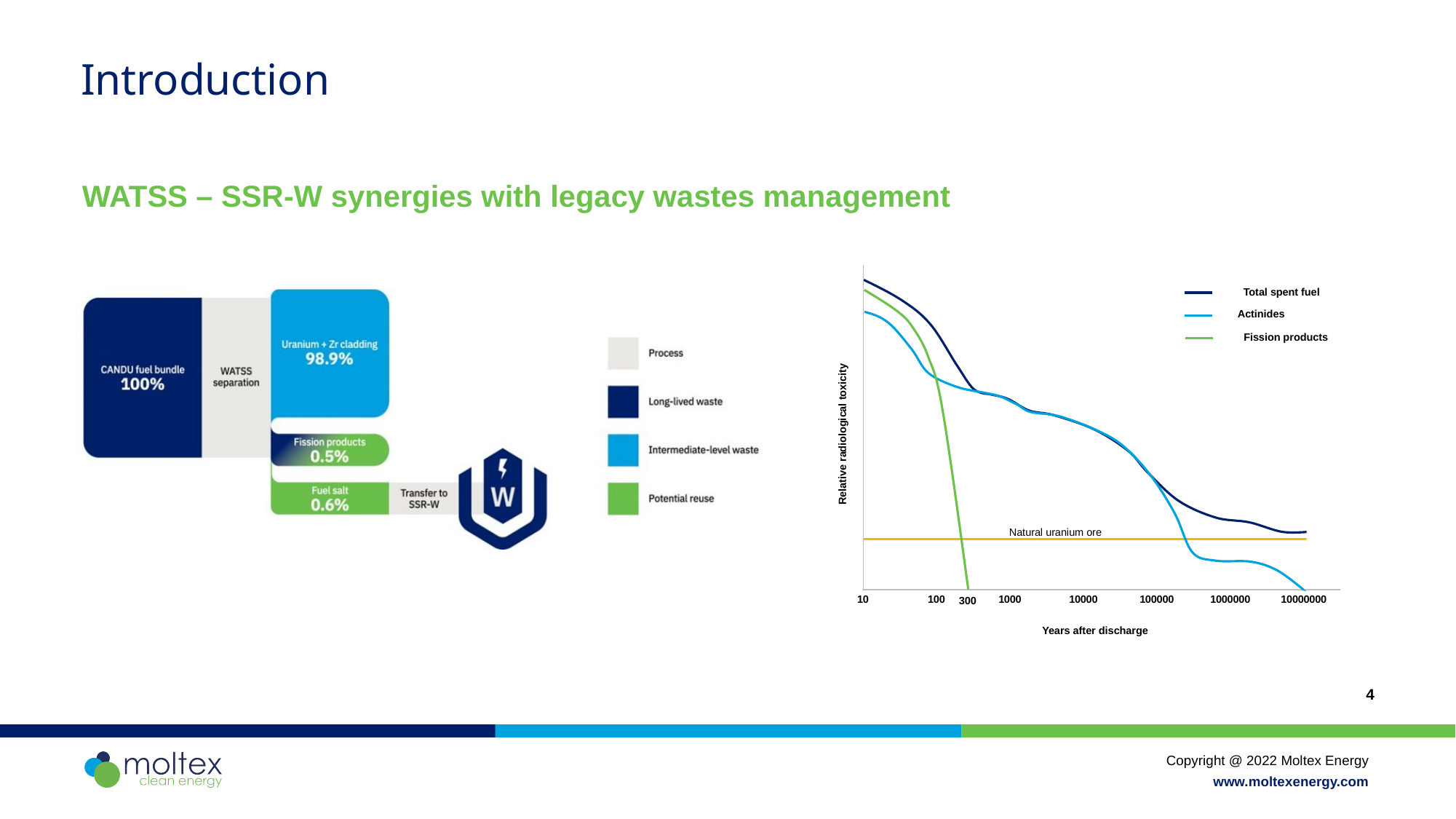
In the line chart, does the Fission products series rise or fall as years after discharge increase? Fall In the line chart, at 1000000 years after discharge, is the Actinides series above or below the Natural uranium ore line? Below In the line chart, which series drops below the Natural uranium ore line first? Fission products What kind of chart is shown on the right side of the slide? Line chart What is the label of the horizontal reference line in the line chart? Natural uranium ore What are the three series named in the legend of the line chart? Total spent fuel, Actinides, Fission products How many series does the legend of the line chart list? 3 What is the label of the x axis of the line chart? Years after discharge In the line chart, does the Total spent fuel series rise or fall along the x axis? Fall